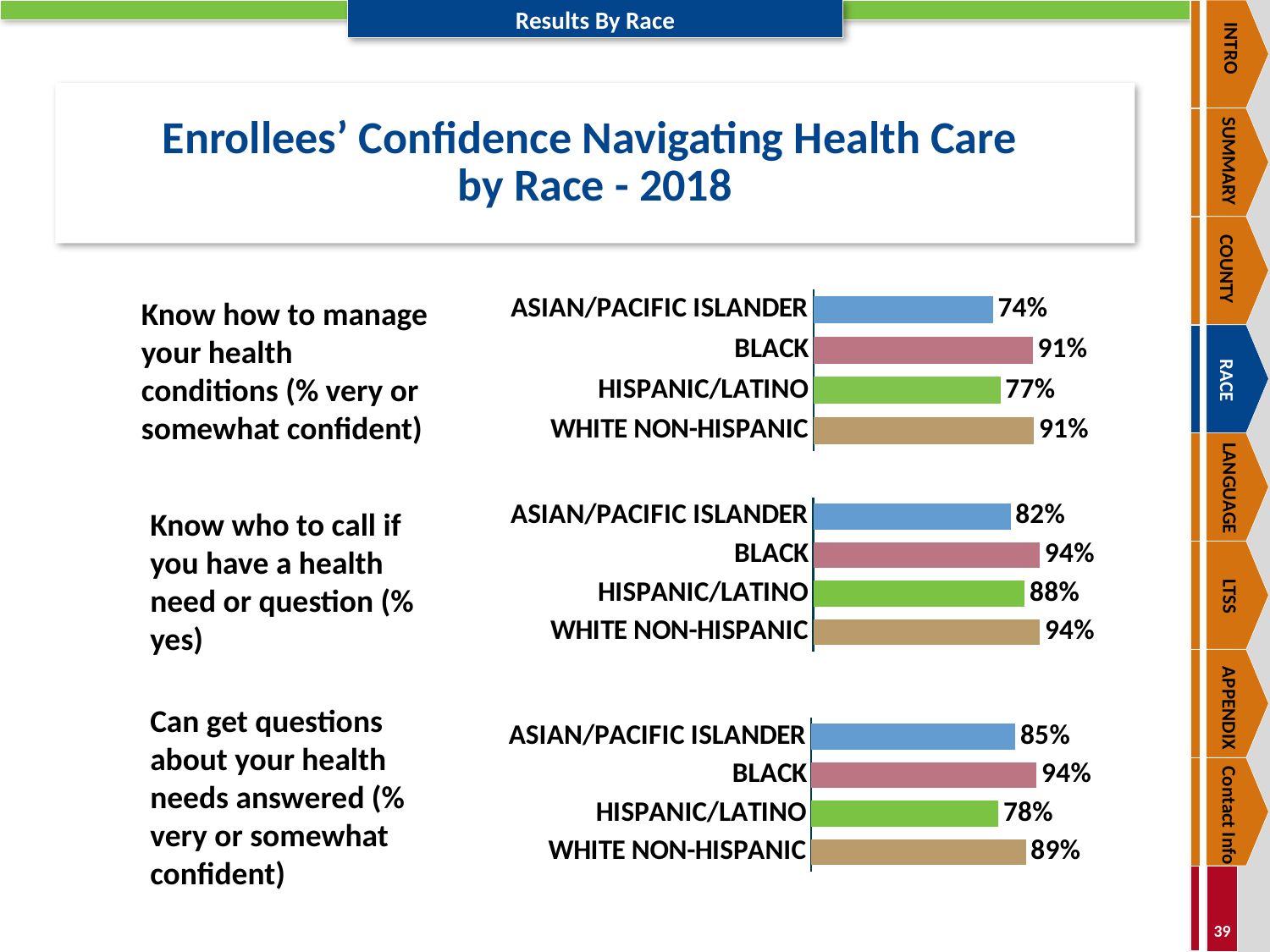
What type of chart is used for the middle chart (Know who to call if you have a health need or question)? Bar chart In the top chart (Know how to manage your health conditions), what is the difference between the Black and Hispanic/Latino values? 14 percentage points In the middle chart (Know who to call if you have a health need or question), which is larger: the value for Black or the value for Hispanic/Latino? Black In the top chart (Know how to manage your health conditions), which race has the lowest value? Asian/Pacific Islander In the bottom chart (Can get questions about your health needs answered), which race has the lowest value? Hispanic/Latino In the bottom chart (Can get questions about your health needs answered), which race has the highest value? Black In the middle chart (Know who to call if you have a health need or question), what is the value for Hispanic/Latino? 88% How many race categories are shown in the top chart (Know how to manage your health conditions)? 4 In the top chart (Know how to manage your health conditions), what is the value for Asian/Pacific Islander? 74% In the bottom chart (Can get questions about your health needs answered), what is the value for White Non-Hispanic? 89% In the bottom chart (Can get questions about your health needs answered), what is the difference between the Black and Hispanic/Latino values? 16 percentage points In the middle chart (Know who to call if you have a health need or question), which race has the lowest value? Asian/Pacific Islander